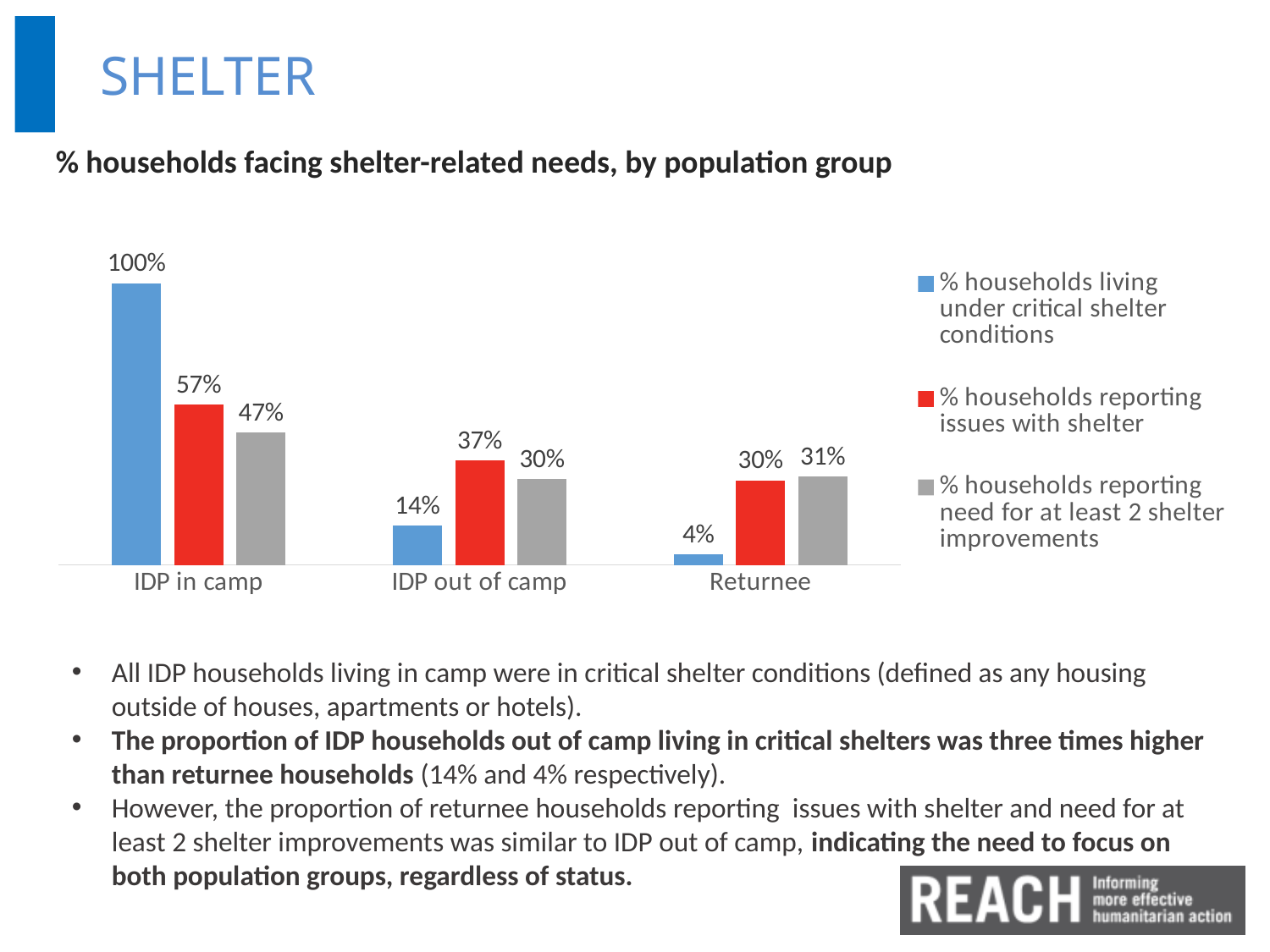
How many population groups are shown on the x axis of the chart? 3 Which population group has the highest percentage of households living under critical shelter conditions? IDP in camp What kind of chart is shown on the slide? Bar chart What percentage of IDP in camp households are living under critical shelter conditions? 100% How many series does the chart legend list? 3 What percentage of IDP out of camp households report need for at least 2 shelter improvements? 30% What is the difference between the percentage of IDP out of camp households and Returnee households living under critical shelter conditions? 10% What is the difference between the percentage of IDP in camp households reporting issues with shelter and those reporting need for at least 2 shelter improvements? 10% Which colour represents the series '% households reporting issues with shelter' in the chart? Red Which population group has the lowest percentage of households living under critical shelter conditions? Returnee What percentage of Returnee households report issues with shelter? 30% Which is larger: the percentage of IDP in camp households reporting issues with shelter or the percentage of IDP out of camp households reporting issues with shelter? IDP in camp